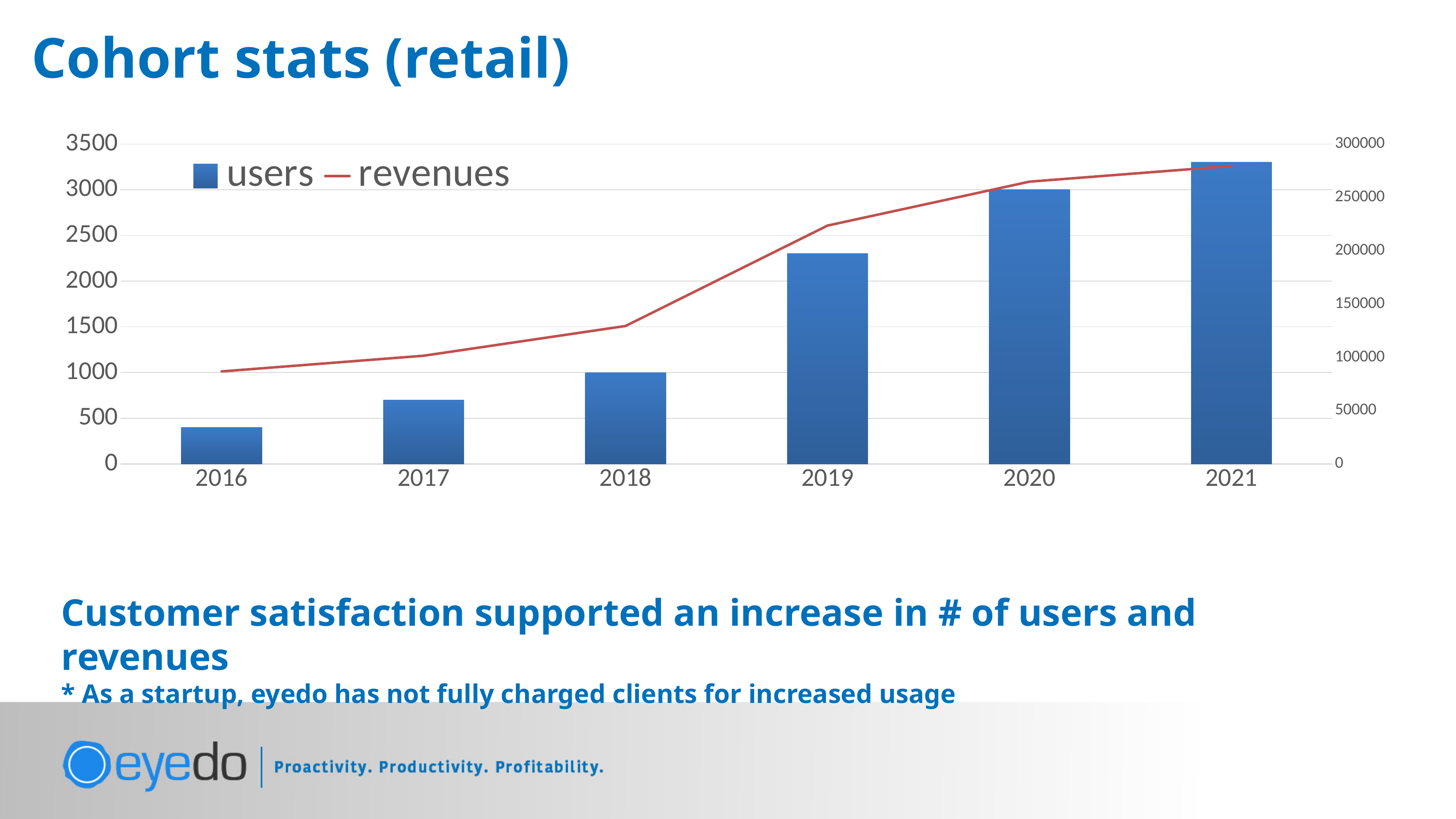
Which year has the lowest number of users? 2016 Do the revenues rise or fall from 2016 to 2021? Rise What kind of chart is shown on the slide? A bar chart combined with a line chart Which year has the highest number of users? 2021 Is the number of users in 2016 greater or less than 500? less Which series is drawn as a red line? revenues How many series does the legend list? 2 How many years are shown on the x axis? 6 What is the difference in users between 2020 and 2018? 2000 Is the revenue value for 2019 greater or less than 200000? greater What is the number of users in 2018? 1000 What is the number of users in 2020? 3000